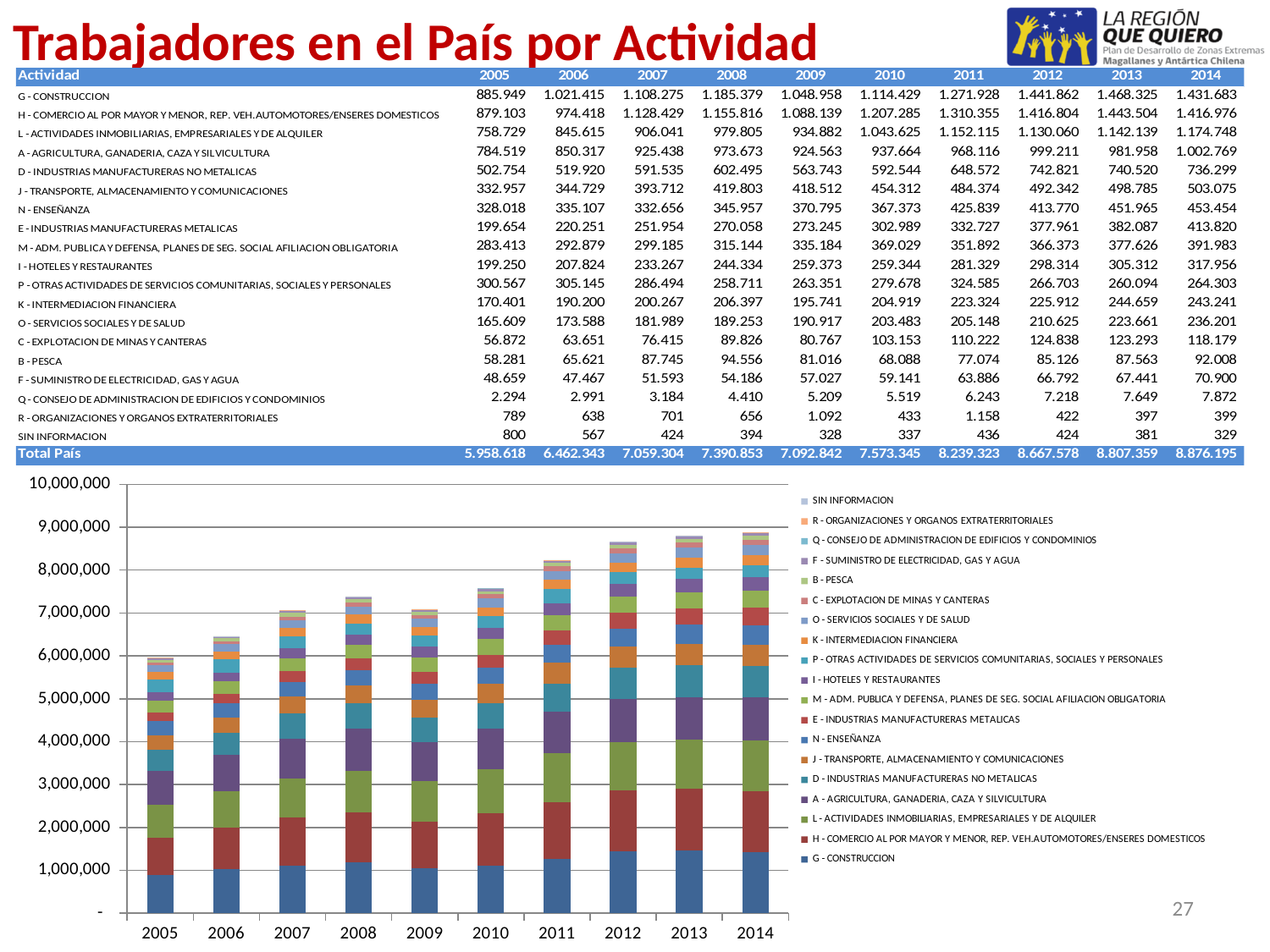
Is the total bar height for 2011 greater or less than 8,000,000? greater Which year has the tallest stacked bar in the chart? 2014 Is the total bar height for 2005 greater or less than 6,000,000? less According to the Total País row, what is the total number of workers in 2014? 8.876.195 Do the stacked bar totals generally rise or fall from 2005 to 2014? rise Which year has the taller stacked bar, 2008 or 2009? 2008 What kind of chart is shown on the slide? Stacked bar chart How many years (bars) does the chart show along the x axis? 10 Is the total bar height for 2009 greater or less than 7,000,000? greater Which series is listed last (at the bottom) in the chart's legend? G - CONSTRUCCION How many series does the chart's legend list? 19 Which year has the shortest stacked bar in the chart? 2005